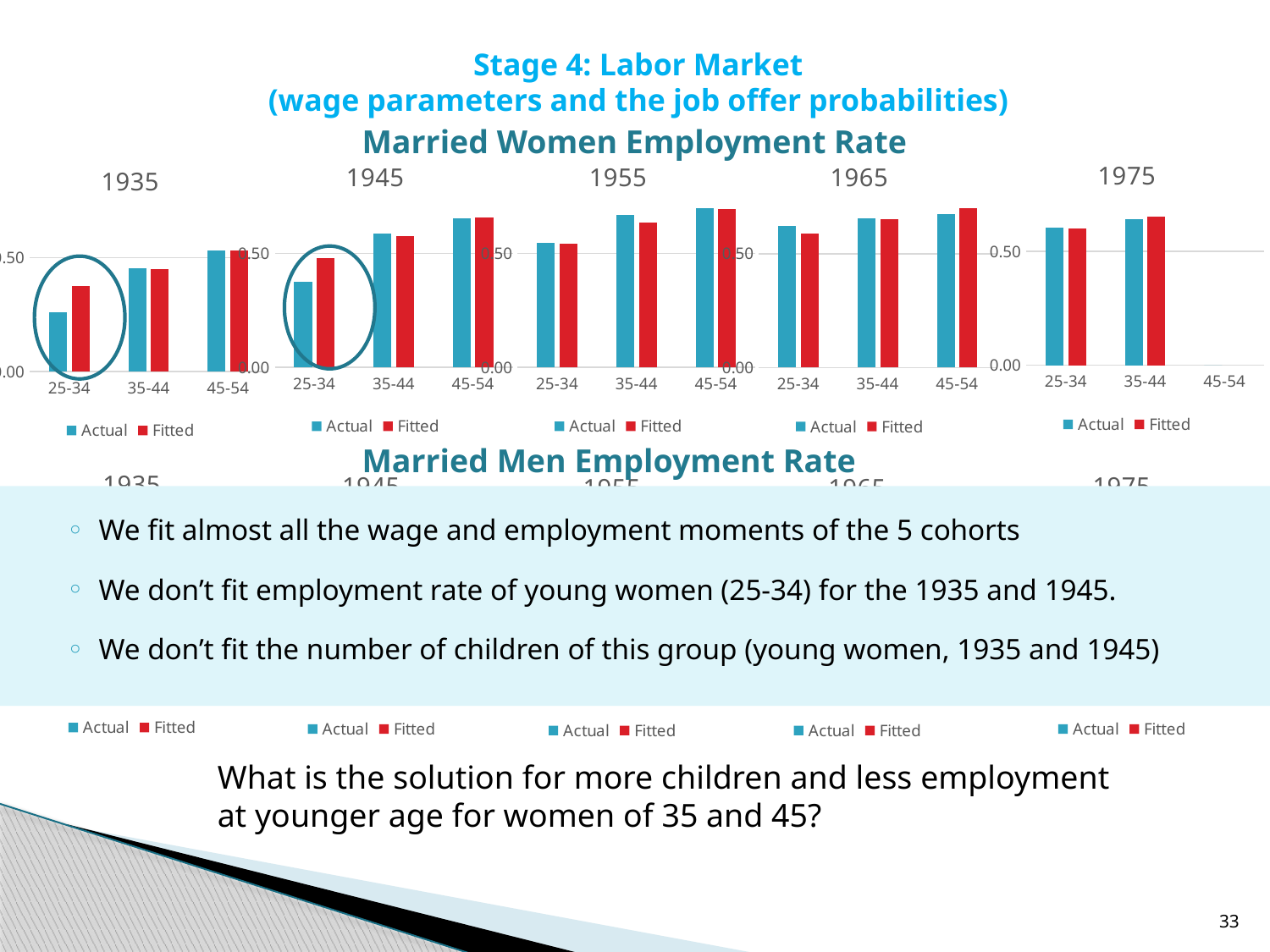
How many age-group categories are shown on the x axis of the 1955 Married Women Employment Rate chart? 3 In the 1935 Married Women Employment Rate chart, for the 25-34 group, which is larger: Actual or Fitted? Fitted In the 1935 Married Women Employment Rate chart, which age group has the highest Actual value? 45-54 What kind of chart is the 1975 Married Women Employment Rate chart? bar chart In the 1935 Married Women Employment Rate chart, is the Actual value for 25-34 greater or less than 0.50? less How many series does the legend of the 1965 Married Women Employment Rate chart list? 2 In the 1945 Married Women Employment Rate chart, do the Actual values rise or fall from 25-34 to 45-54? rise In the 1945 Married Women Employment Rate chart, is the Actual value for 25-34 greater or less than 0.50? less In the 1945 Married Women Employment Rate chart, for the 25-34 group, which is larger: Actual or Fitted? Fitted In the 1935 Married Women Employment Rate chart, which age group has the lowest Actual value? 25-34 In the 1945 Married Women Employment Rate chart, is the Actual value for 45-54 greater or less than 0.50? greater